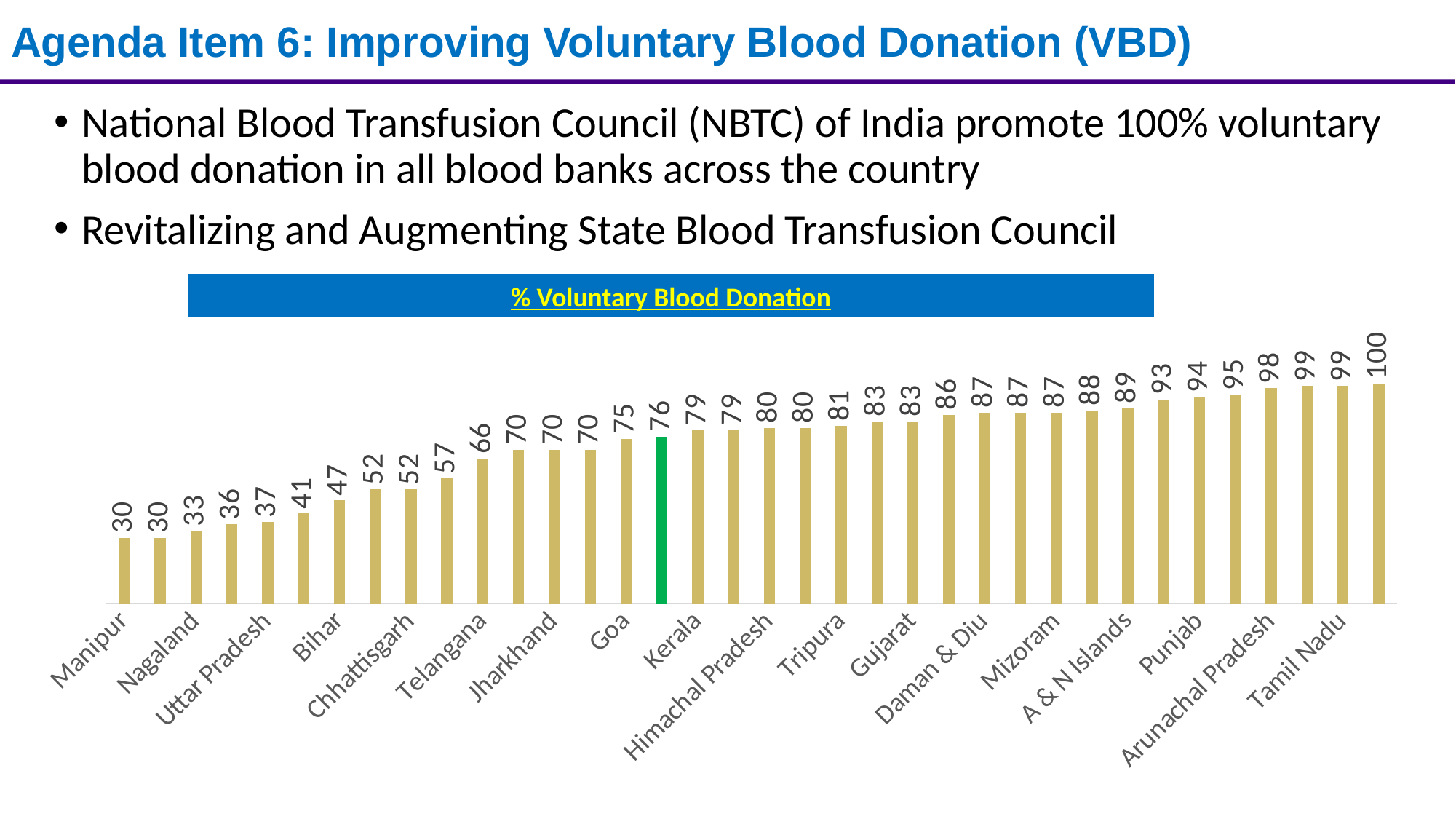
What is the lowest value shown in the chart? 30 What is the value for Jharkhand? 70 What is the title of the chart? % Voluntary Blood Donation What is the difference between the values for Kerala and Manipur? 49 What is the value for Kerala? 79 What is the value for Mizoram? 87 Which has a larger value, Gujarat or Chhattisgarh? Gujarat What type of chart is shown on the slide? bar chart What is the highest value shown in the chart? 100 What is the value for Manipur? 30 What is the value for Himachal Pradesh? 80 Do the values rise or fall from left to right along the x axis? rise